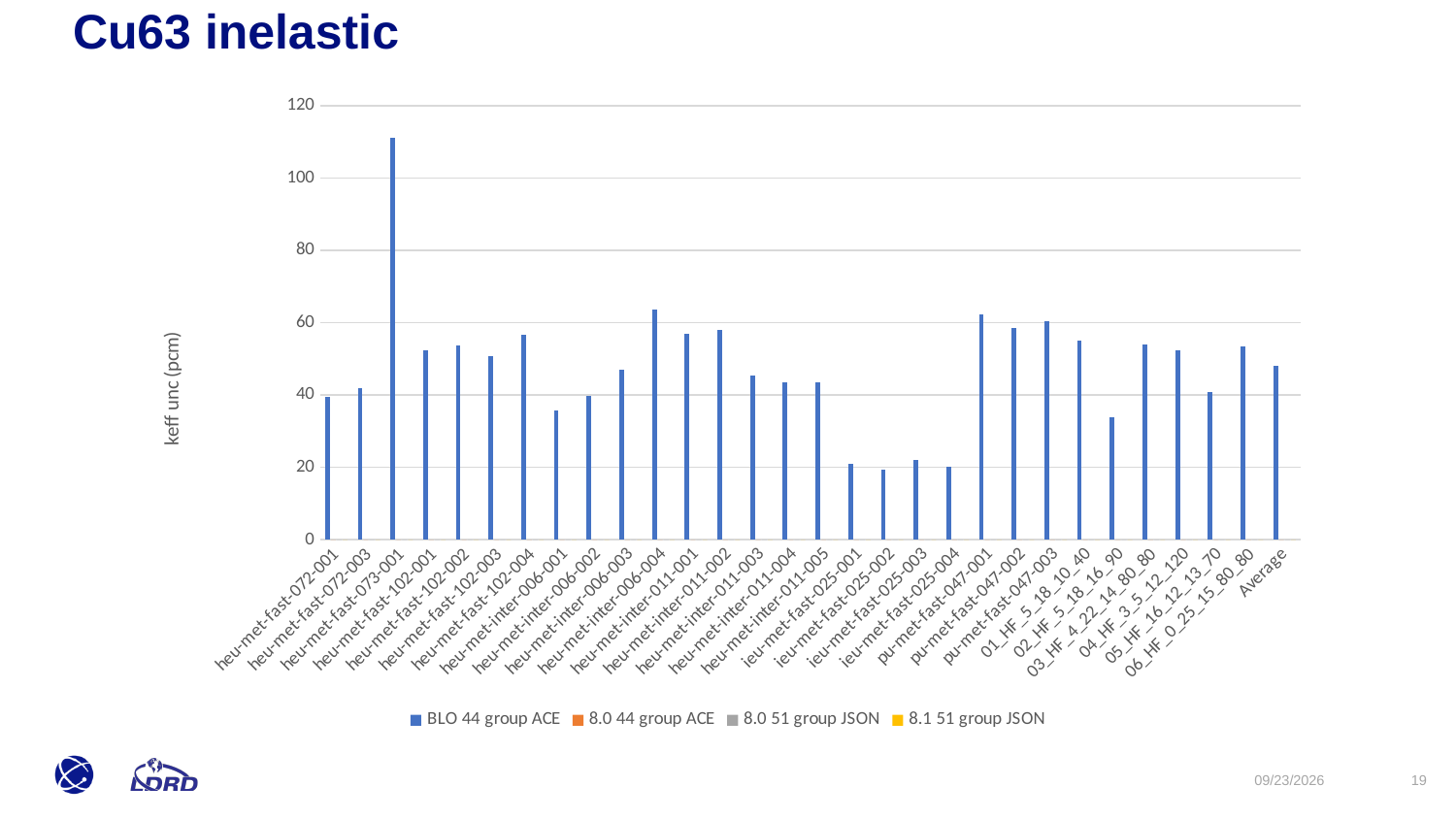
Is the value for Average greater or less than 60? less Is the value for heu-met-inter-006-001 greater or less than 40? less Which is larger, the value for ieu-met-fast-025-003 or the value for pu-met-fast-047-002? pu-met-fast-047-002 How many series does the legend list? 4 How many categories are shown along the x axis? 30 Is the value for ieu-met-fast-025-001 greater or less than 40? less What is the label on the y axis? keff unc (pcm) What kind of chart is shown on the slide? bar chart Which is larger, the value for heu-met-fast-073-001 or the value for heu-met-fast-072-001? heu-met-fast-073-001 Which category has the highest keff unc value? heu-met-fast-073-001